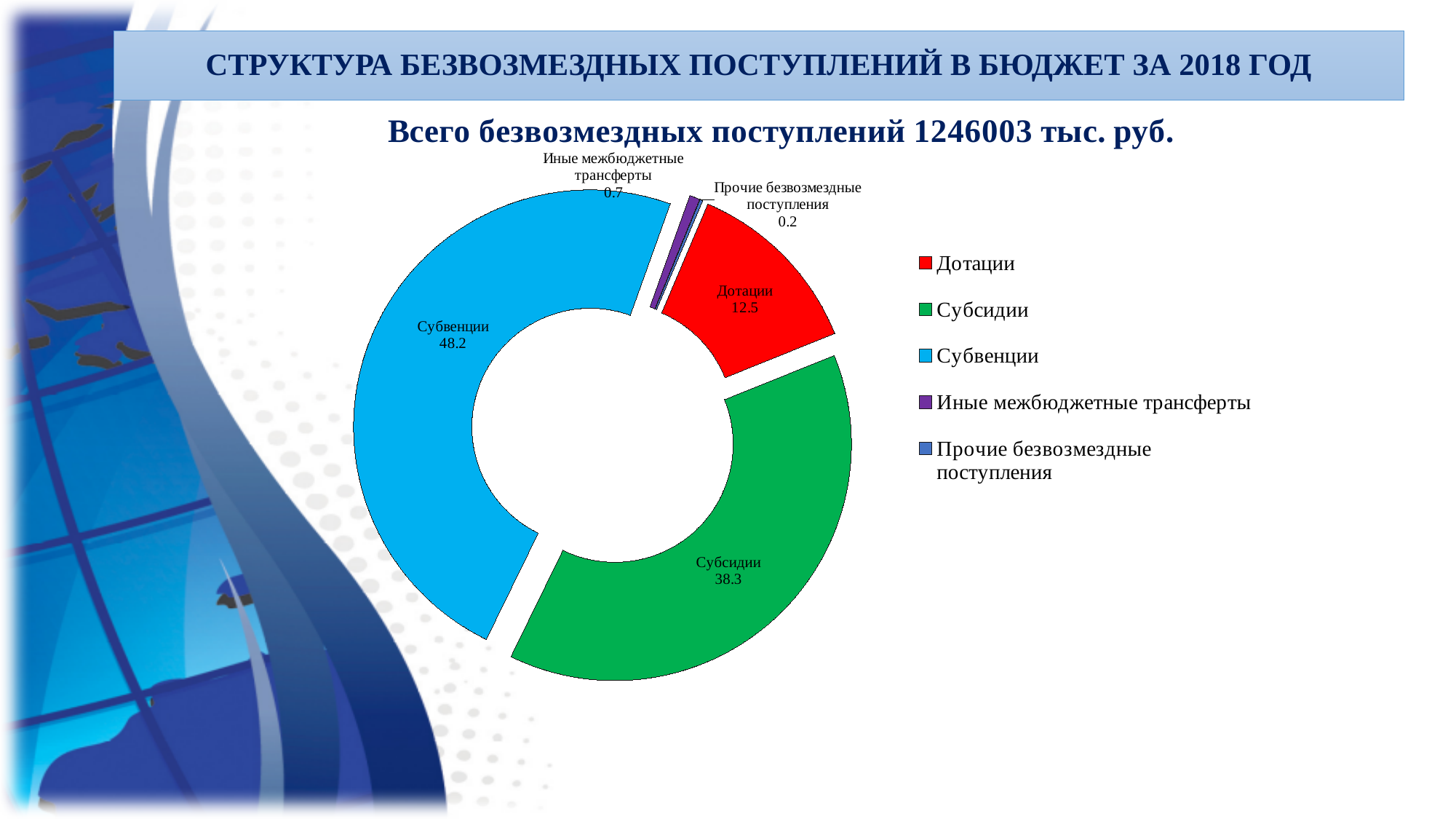
What value is shown for Иные межбюджетные трансферты? 0.7 Which category has the smallest share of the chart? Прочие безвозмездные поступления What value is shown for Дотации? 12.5 What is the difference between the values for Субвенции and Субсидии? 9.9 What total amount of gratuitous receipts is stated in the chart title? 1246003 тыс. руб. What kind of chart is shown on the slide? Doughnut (pie) chart Which category has the largest share of the chart? Субвенции Which is larger, the value for Дотации or the value for Субсидии? Субсидии What value is shown for Субвенции? 48.2 How many categories does the chart show? 5 What value is shown for Субсидии? 38.3 What value is shown for Прочие безвозмездные поступления? 0.2